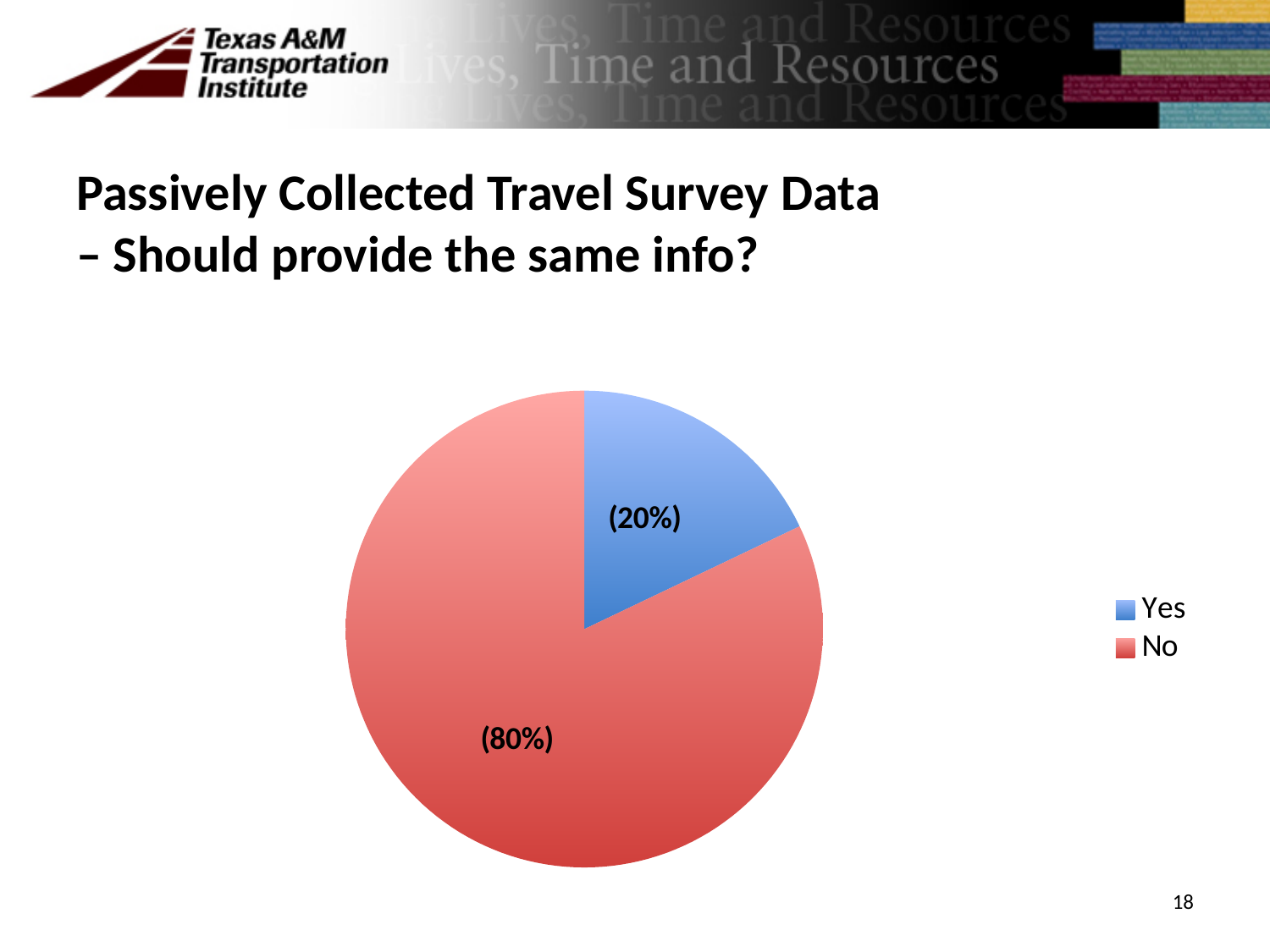
What colour is the "Yes" slice in the pie chart? blue What kind of chart is shown on the slide? pie chart What colour is the "No" slice in the pie chart? red What share of the pie does the "Yes" slice represent? (20%) What is the difference in percentage points between the "No" slice and the "Yes" slice? 60% What share of the pie does the "No" slice represent? (80%) Which is larger, the "Yes" slice or the "No" slice? No How many slices does the pie chart have? 2 Which slice is the largest in the pie chart? No Which slice is the smallest in the pie chart? Yes How many entries does the legend list? 2